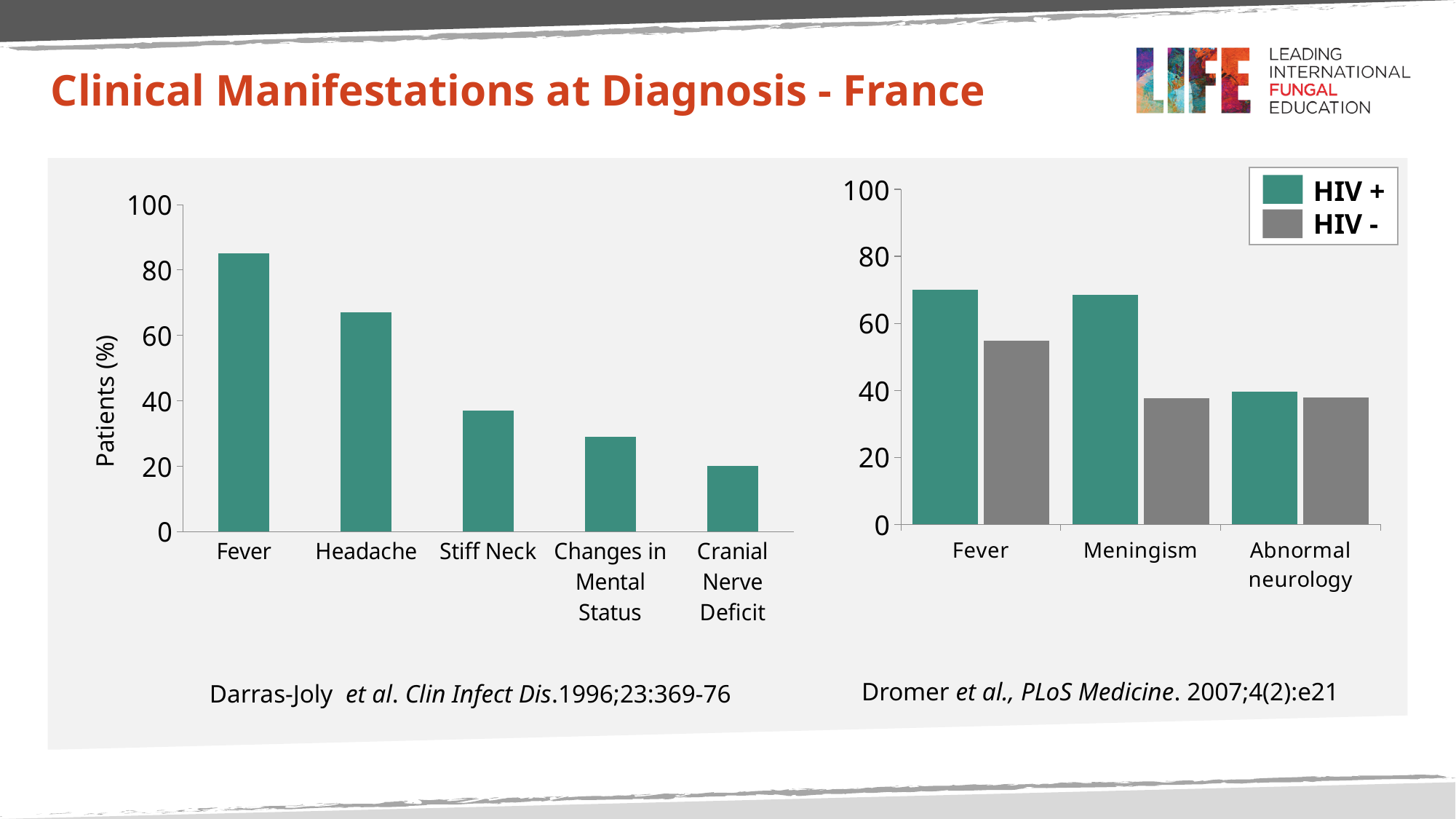
What kind of chart is the left chart on the slide? bar chart On the right chart, is the HIV + value for Fever greater or less than 60? greater On the left chart, is the value for Headache greater or less than 60? greater On the right chart, which is larger for Meningism, HIV + or HIV -? HIV + What is the y-axis label on the left chart? Patients (%) On the left chart, is the value for Stiff Neck greater or less than 40? less How many series does the legend of the right chart list? 2 On the left chart, which category has the lowest value? Cranial Nerve Deficit On the left chart, do the values rise or fall from left to right along the x axis? fall How many categories are shown on the left chart? 5 On the left chart, which category has the highest value? Fever On the right chart, which category has the lowest HIV + value? Abnormal neurology